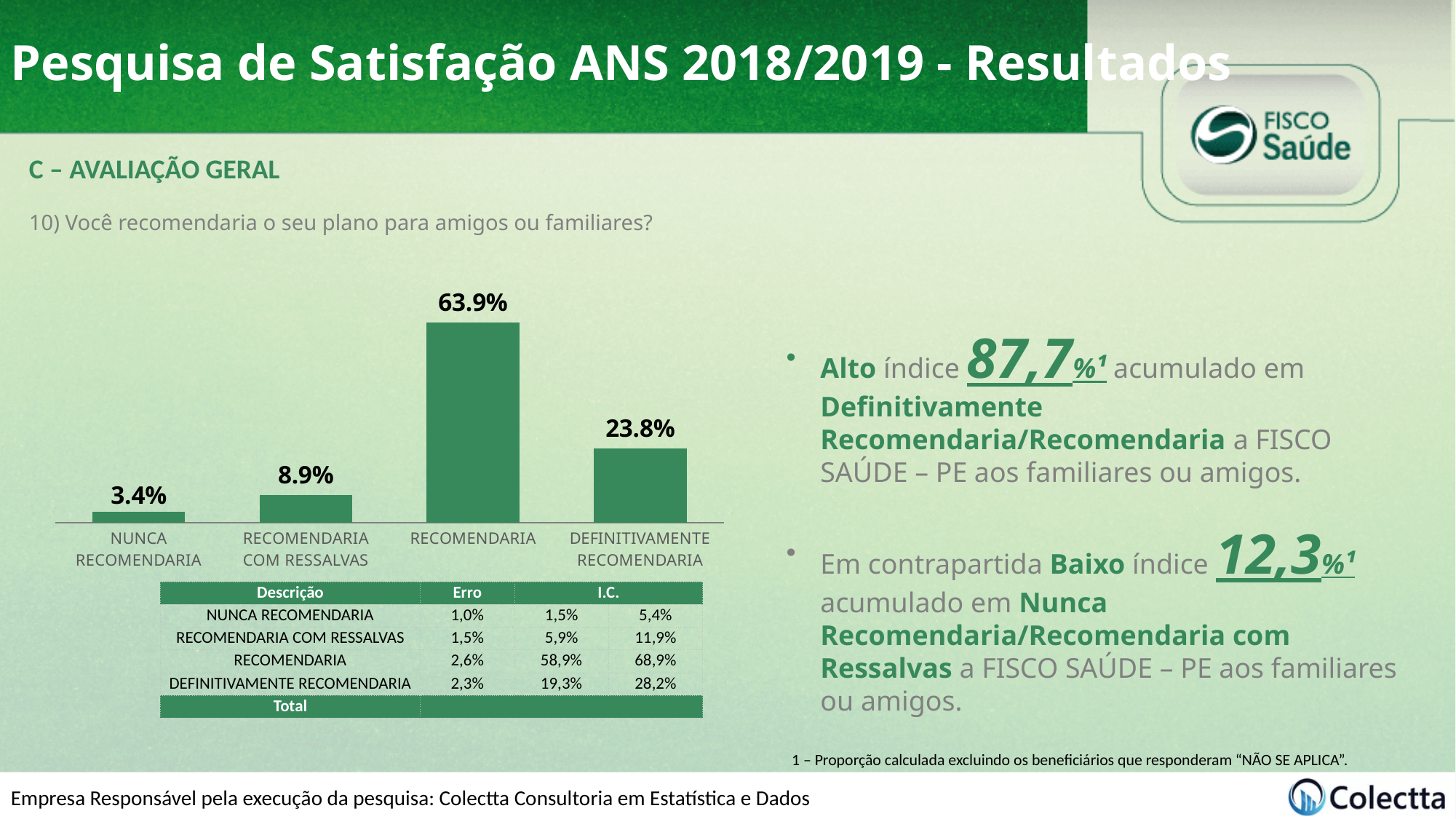
Which category has the lowest value? NUNCA RECOMENDARIA What is the difference between the values for RECOMENDARIA and DEFINITIVAMENTE RECOMENDARIA? 40.1% What is the value for NUNCA RECOMENDARIA? 3.4% How many categories are shown in the bar chart? 4 What is the value for RECOMENDARIA COM RESSALVAS? 8.9% What is the value for DEFINITIVAMENTE RECOMENDARIA? 23.8% What colour are the bars in the chart? Green Which is larger, the value for DEFINITIVAMENTE RECOMENDARIA or the value for RECOMENDARIA COM RESSALVAS? DEFINITIVAMENTE RECOMENDARIA Which category has the highest value? RECOMENDARIA What is the value for RECOMENDARIA? 63.9% What is the difference between the values for RECOMENDARIA COM RESSALVAS and NUNCA RECOMENDARIA? 5.5% What kind of chart is shown on the slide? Bar chart